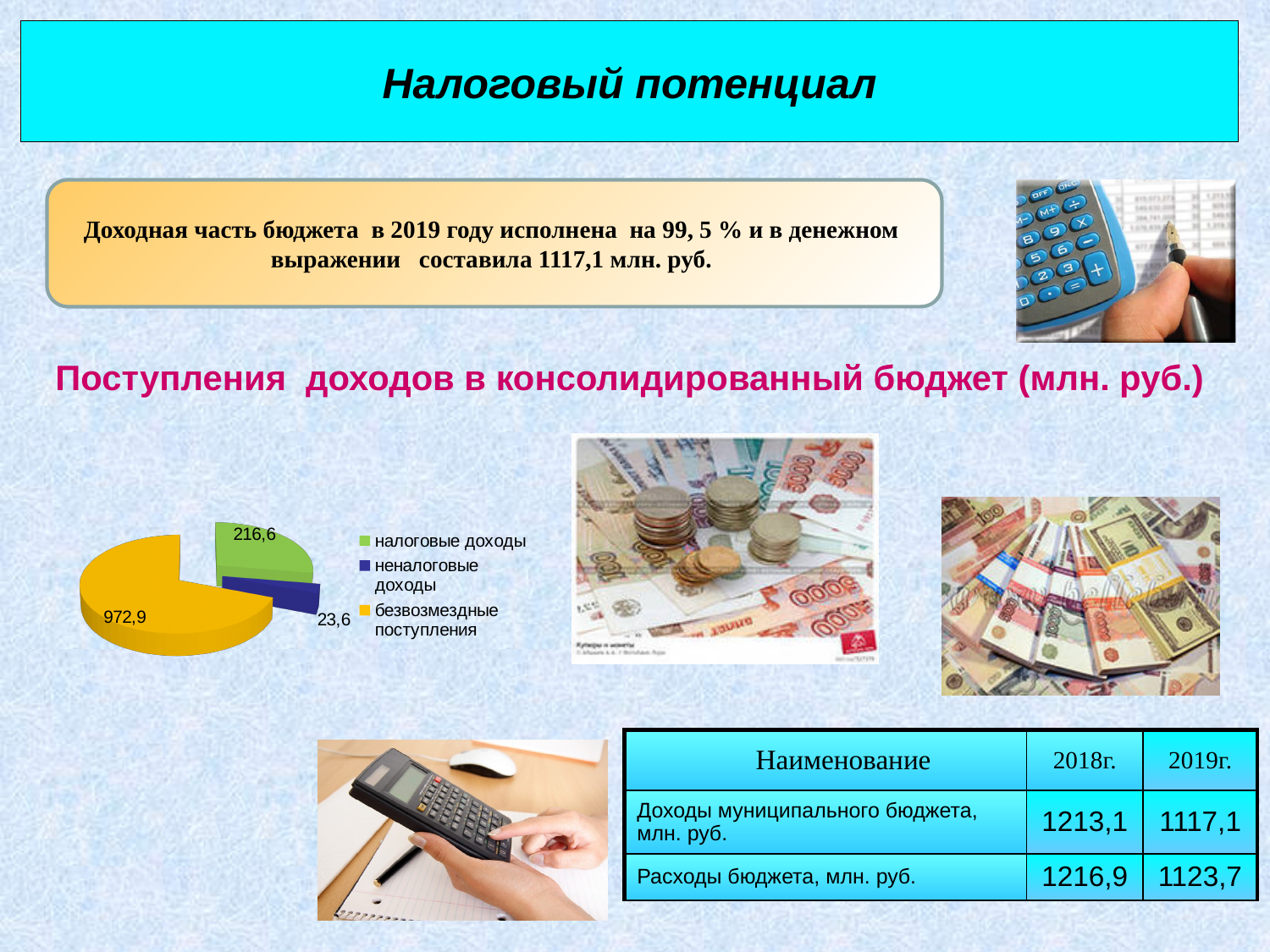
Which category has the largest slice in the pie chart? безвозмездные поступления What kind of chart is shown on the slide? pie chart What is the value for безвозмездные поступления in the pie chart? 972,9 What is the difference between безвозмездные поступления and налоговые доходы in the pie chart? 756,3 How many slices does the pie chart have? 3 What is the difference between налоговые доходы and неналоговые доходы in the pie chart? 193,0 Which is larger in the pie chart: налоговые доходы or неналоговые доходы? налоговые доходы Which category has the smallest slice in the pie chart? неналоговые доходы What is the value for неналоговые доходы in the pie chart? 23,6 What is the value for налоговые доходы in the pie chart? 216,6 How many entries does the legend of the pie chart list? 3 What colour is the slice for безвозмездные поступления in the pie chart? yellow